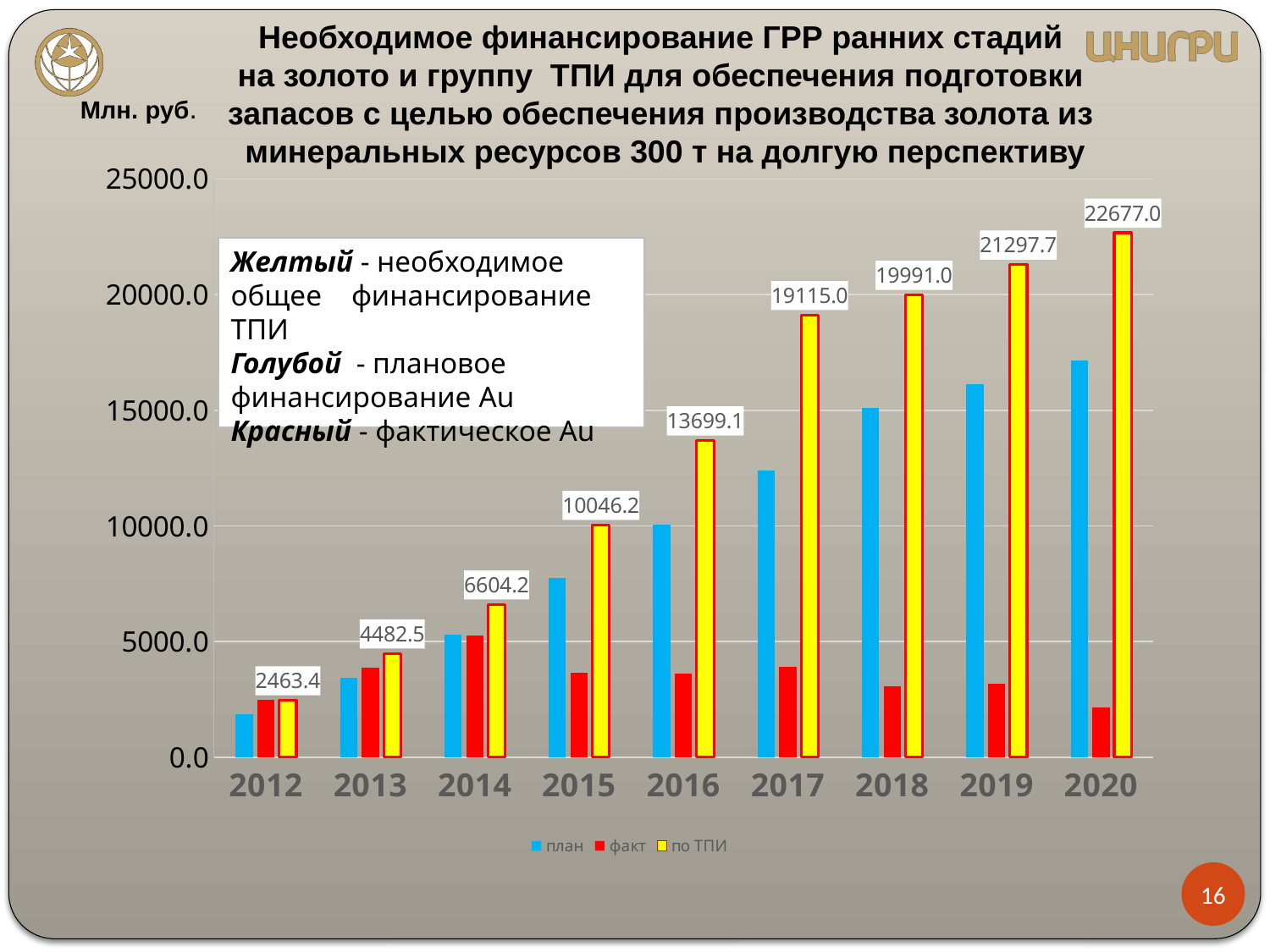
In which year is the "по ТПИ" value highest? 2020 How many series does the legend list? 3 What is the value of the "по ТПИ" series for 2020? 22677.0 What is the value of the "по ТПИ" series for 2012? 2463.4 In which year is the "по ТПИ" value lowest? 2012 How many years are shown on the x axis? 9 What is the value of the "по ТПИ" series for 2015? 10046.2 What type of chart is shown on the slide? bar chart What is the difference between the "по ТПИ" values for 2020 and 2019? 1379.3 Which is larger, the "по ТПИ" value for 2017 or for 2016? 2017 Is the "план" value for 2020 greater or less than 15000.0? greater Does the "по ТПИ" series rise or fall from 2012 to 2020? rise